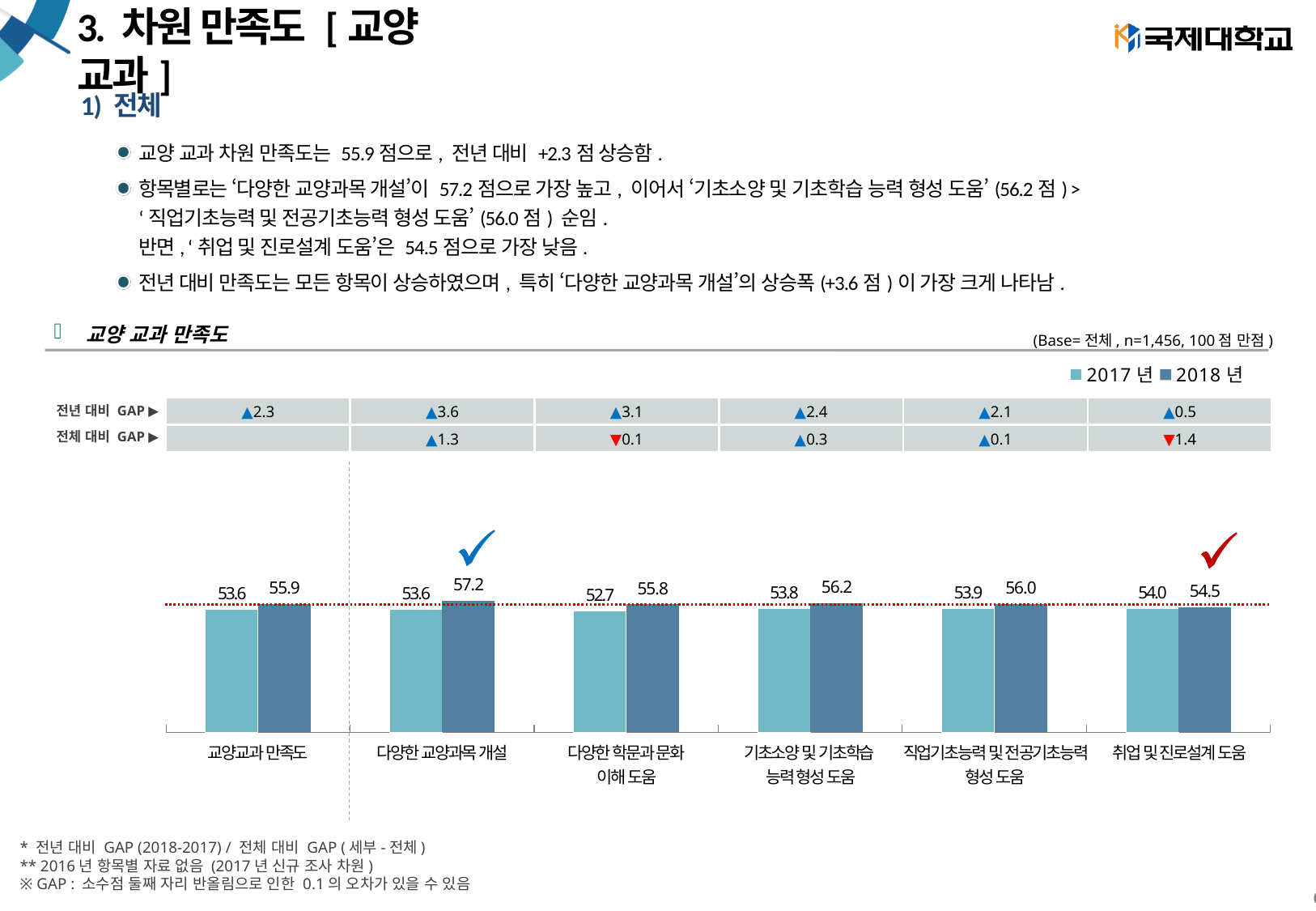
How many categories are shown on the x axis of the chart? 6 Which category has the highest 2018년 value? 다양한 교양과목 개설 What is the difference between the 2018년 and 2017년 values for 다양한 교양과목 개설? 3.6 What are the two series named in the chart legend? 2017년 and 2018년 What is the difference between the 2018년 values for 기초소양 및 기초학습 능력 형성 도움 and 취업 및 진로설계 도움? 1.7 What is the 2018년 value for 취업 및 진로설계 도움? 54.5 Which is larger: the 2018년 value for 직업기초능력 및 전공기초능력 형성 도움 or the 2018년 value for 취업 및 진로설계 도움? 직업기초능력 및 전공기초능력 형성 도움 Which category has the lowest 2017년 value? 다양한 학문과 문화 이해 도움 What is the 2017년 value for 다양한 학문과 문화 이해 도움? 52.7 What is the 2018년 value for 다양한 교양과목 개설? 57.2 How many series does the chart legend list? 2 What kind of chart is shown on the slide? Bar chart